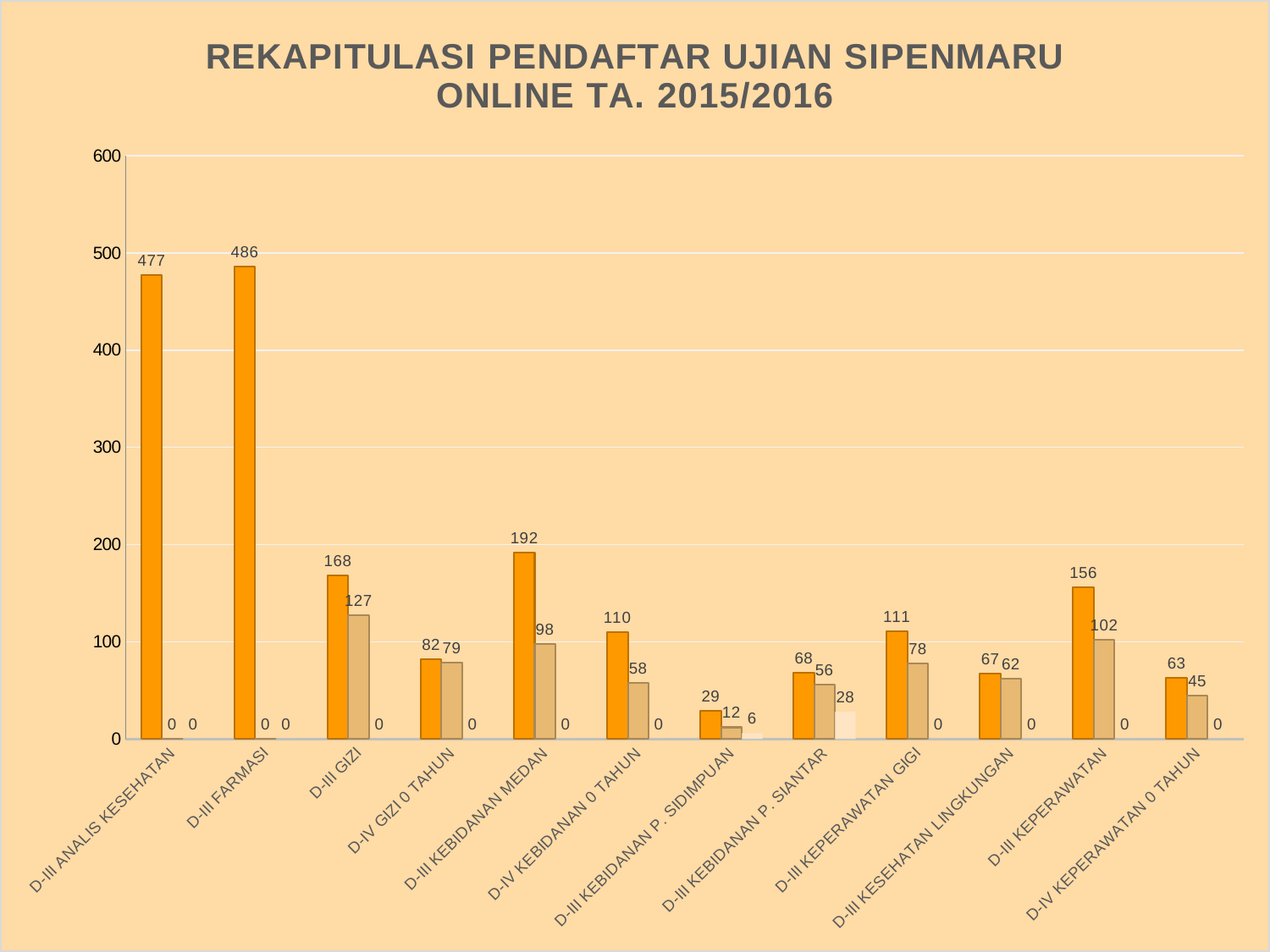
What type of chart is shown on the slide? Bar chart What is the difference between the first (orange) bar values of D-III FARMASI and D-III ANALIS KESEHATAN? 9 What is the value of the third bar for D-III KEBIDANAN P. SIANTAR? 28 Which is larger: the first (orange) bar for D-III KEPERAWATAN GIGI or the first (orange) bar for D-IV KEBIDANAN 0 TAHUN? D-III KEPERAWATAN GIGI How many categories are shown on the x axis? 12 What is the value of the second (tan) bar for D-III GIZI? 127 What is the value of the first (orange) bar for D-III KEBIDANAN MEDAN? 192 Which category has the lowest value for the first (orange) bar? D-III KEBIDANAN P. SIDIMPUAN What is the difference between the first (orange) and second (tan) bar values for D-III KEPERAWATAN? 54 Is the first (orange) bar value for D-III ANALIS KESEHATAN greater or less than 400? greater What is the value of the first (orange) bar for D-III FARMASI? 486 Which category has the highest value for the first (orange) bar? D-III FARMASI